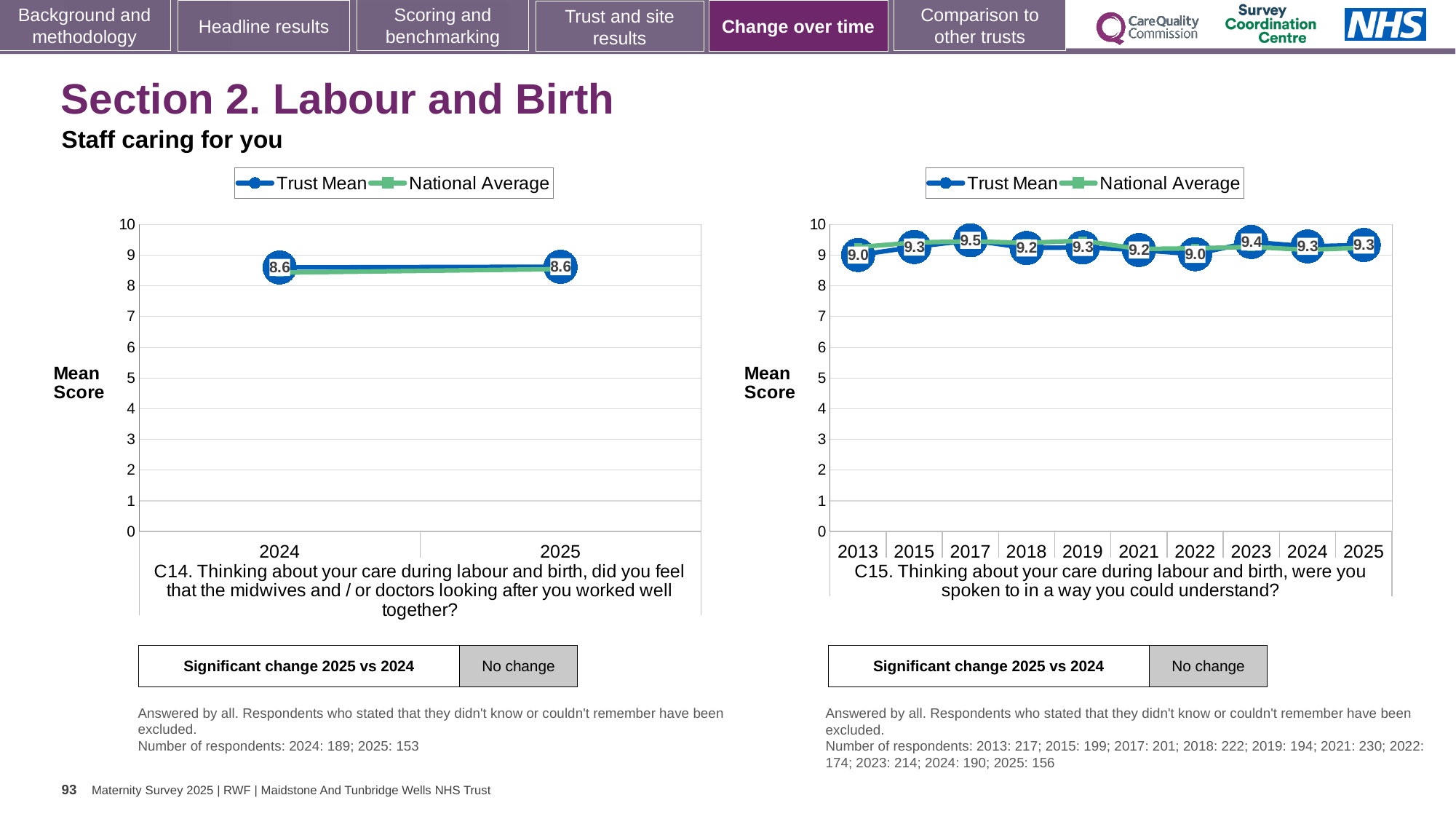
How many years are plotted on the C15 chart (right)? 10 How many series does the legend of the C14 chart (left) list? 2 What kind of chart is the C15 chart (right)? Line chart On the C15 chart (right), what is the Trust Mean score for 2022? 9.0 On the C15 chart (right), which is larger, the Trust Mean score for 2023 or for 2022? 2023 On the C15 chart (right), what is the Trust Mean score for 2017? 9.5 On the C14 chart (left), is the National Average value for 2024 greater or less than 9? less On the C15 chart (right), which year has the highest Trust Mean score? 2017 On the C15 chart (right), what is the difference between the Trust Mean scores for 2017 and 2013? 0.5 On the C14 chart (left), does the Trust Mean rise, fall or stay the same from 2024 to 2025? Stays the same On the C14 chart (left), what is the Trust Mean score for 2025? 8.6 On the C14 chart (left), what is the Trust Mean score for 2024? 8.6